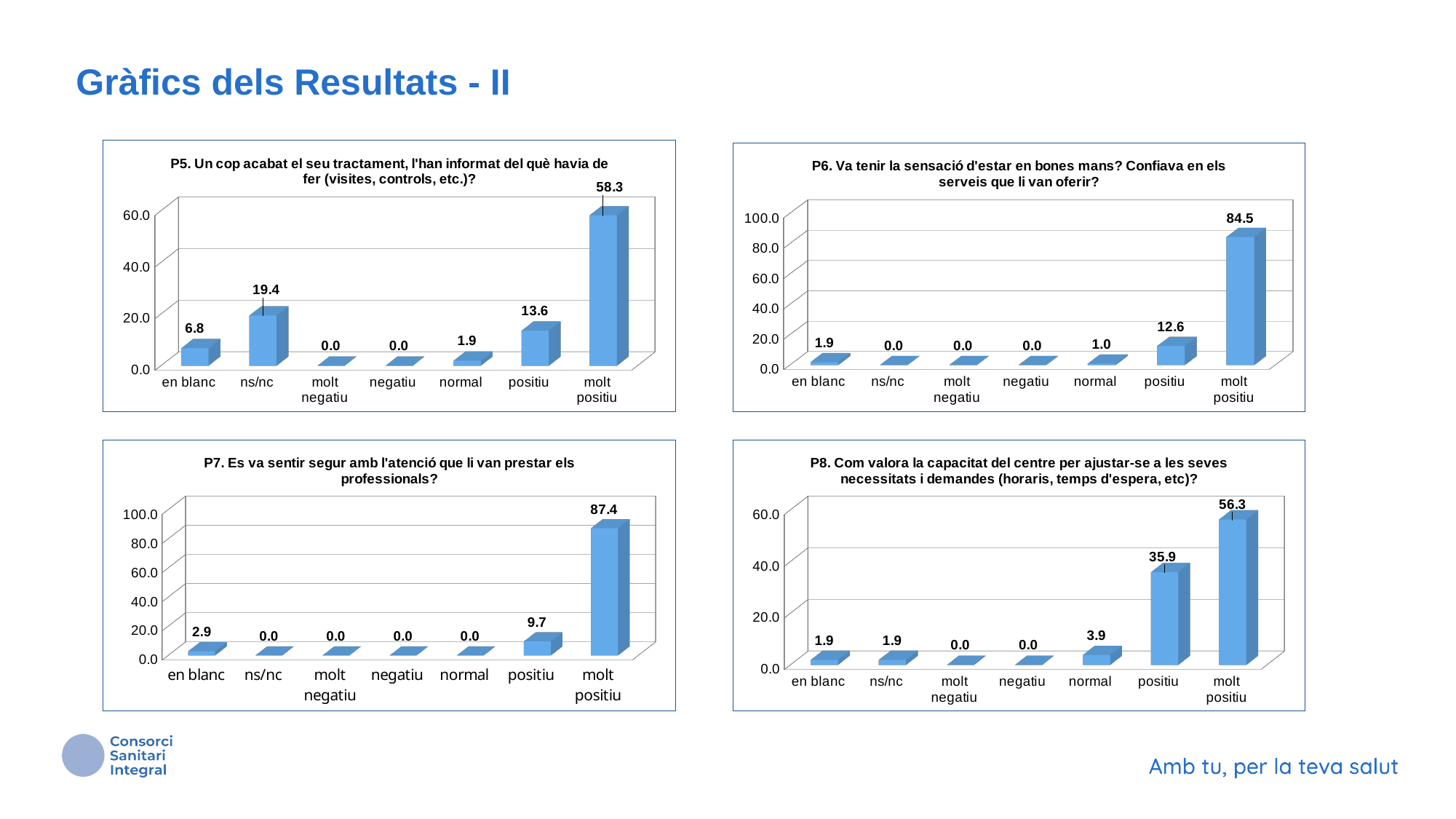
In the P8 chart (bottom right), what is the difference between 'molt positiu' and 'positiu'? 20.4 In the P5 chart (top left), what is the value for 'molt positiu'? 58.3 In the P7 chart (bottom left), how many categories are shown on the x axis? 7 In the P5 chart (top left), what is the value for 'ns/nc'? 19.4 In the P8 chart (bottom right), what is the value for 'positiu'? 35.9 In the P5 chart (top left), what is the difference between 'molt positiu' and 'positiu'? 44.7 In the P6 chart (top right), which category has the highest value? molt positiu In the P8 chart (bottom right), which is larger, 'positiu' or 'molt positiu'? molt positiu In the P6 chart (top right), what is the value for 'positiu'? 12.6 In the P6 chart (top right), is the value for 'molt positiu' greater or less than 80.0? greater What kind of chart is the P7 chart (bottom left)? bar chart In the P7 chart (bottom left), what is the value for 'en blanc'? 2.9